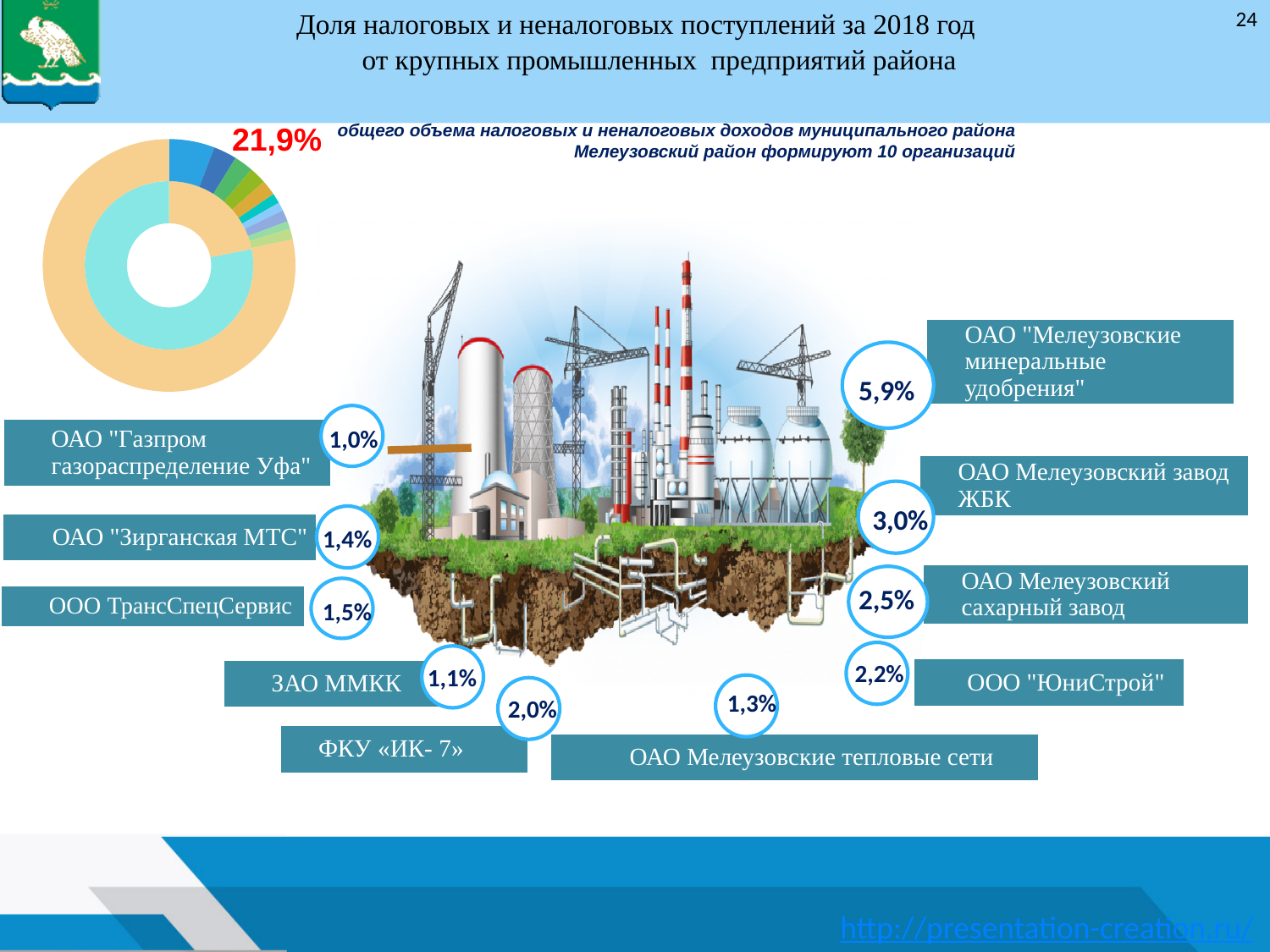
Which has a larger share: ОАО Мелеузовский завод ЖБК or ОАО Мелеузовский сахарный завод? ОАО Мелеузовский завод ЖБК What kind of chart is shown on the slide? pie (donut) chart What share of tax and non-tax revenue is attributed to ОАО "Мелеузовские минеральные удобрения"? 5,9% Which organization has the largest share of revenue on the slide? ОАО "Мелеузовские минеральные удобрения" Which organization has the smallest share of revenue on the slide? ОАО "Газпром газораспределение Уфа" What is the difference between the shares of ОАО "Мелеузовские минеральные удобрения" and ОАО Мелеузовский завод ЖБК? 2,9% What share is shown for ФКУ «ИК-7»? 2,0% For which year does the slide show the share of tax and non-tax revenue? 2018 How many organizations are listed with their revenue shares on the slide? 10 What share is shown for ОАО Мелеузовские тепловые сети? 1,3% What share is shown for ОАО Мелеузовский завод ЖБК? 3,0% What is the combined share of the 10 organizations in the district's total tax and non-tax revenue? 21,9%